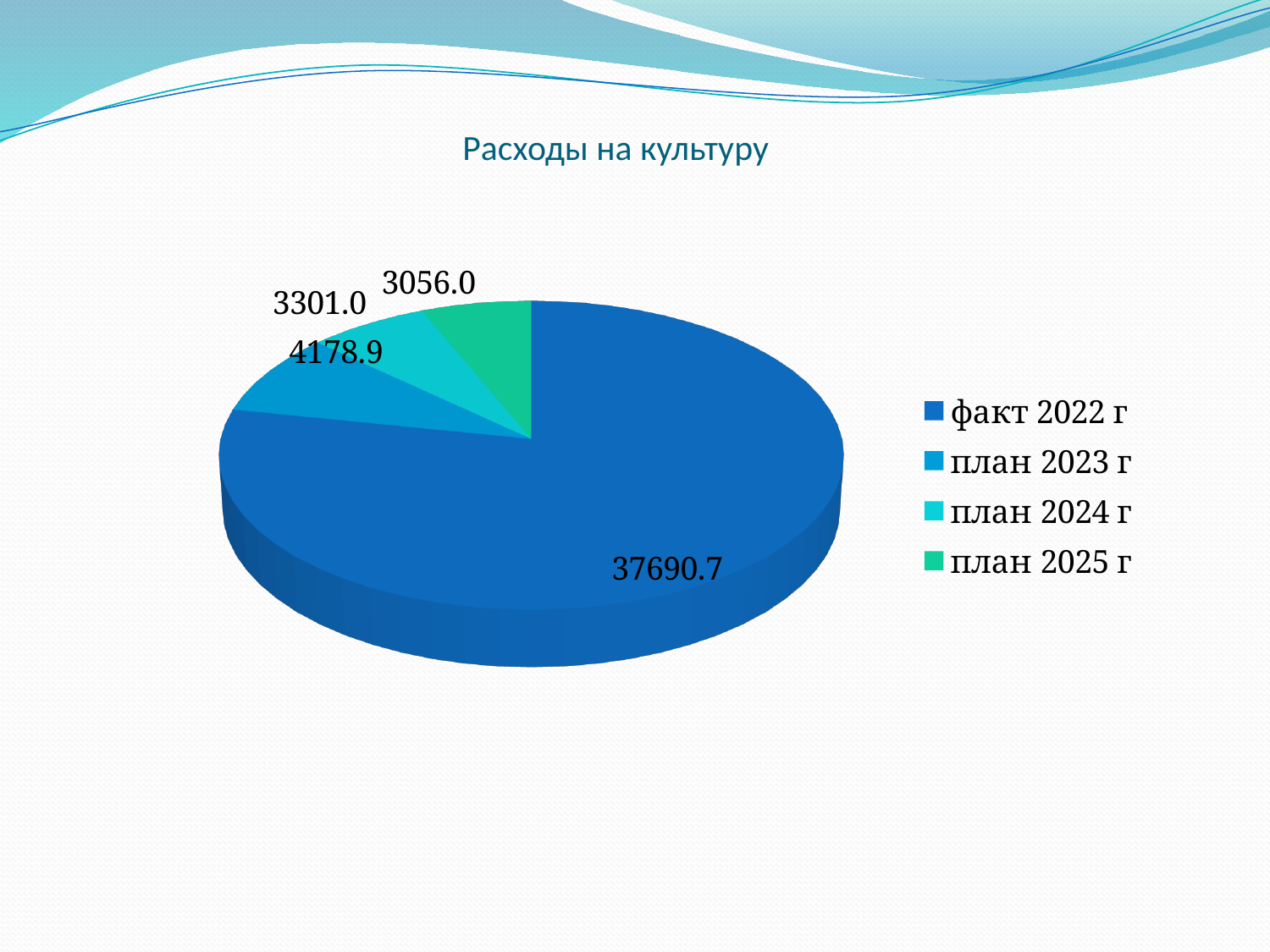
How many entries does the legend list? 4 What is the value for план 2025 г? 3056.0 What is the difference between the values for план 2023 г and план 2024 г? 877.9 What type of chart is shown on the slide? pie chart How many slices does the pie chart have? 4 What is the value for план 2024 г? 3301.0 What is the value for факт 2022 г? 37690.7 What is the title of the chart? Расходы на культуру Which category has the largest slice? факт 2022 г Which is larger, the value for план 2024 г or план 2025 г? план 2024 г Which category has the smallest slice? план 2025 г What is the value for план 2023 г? 4178.9